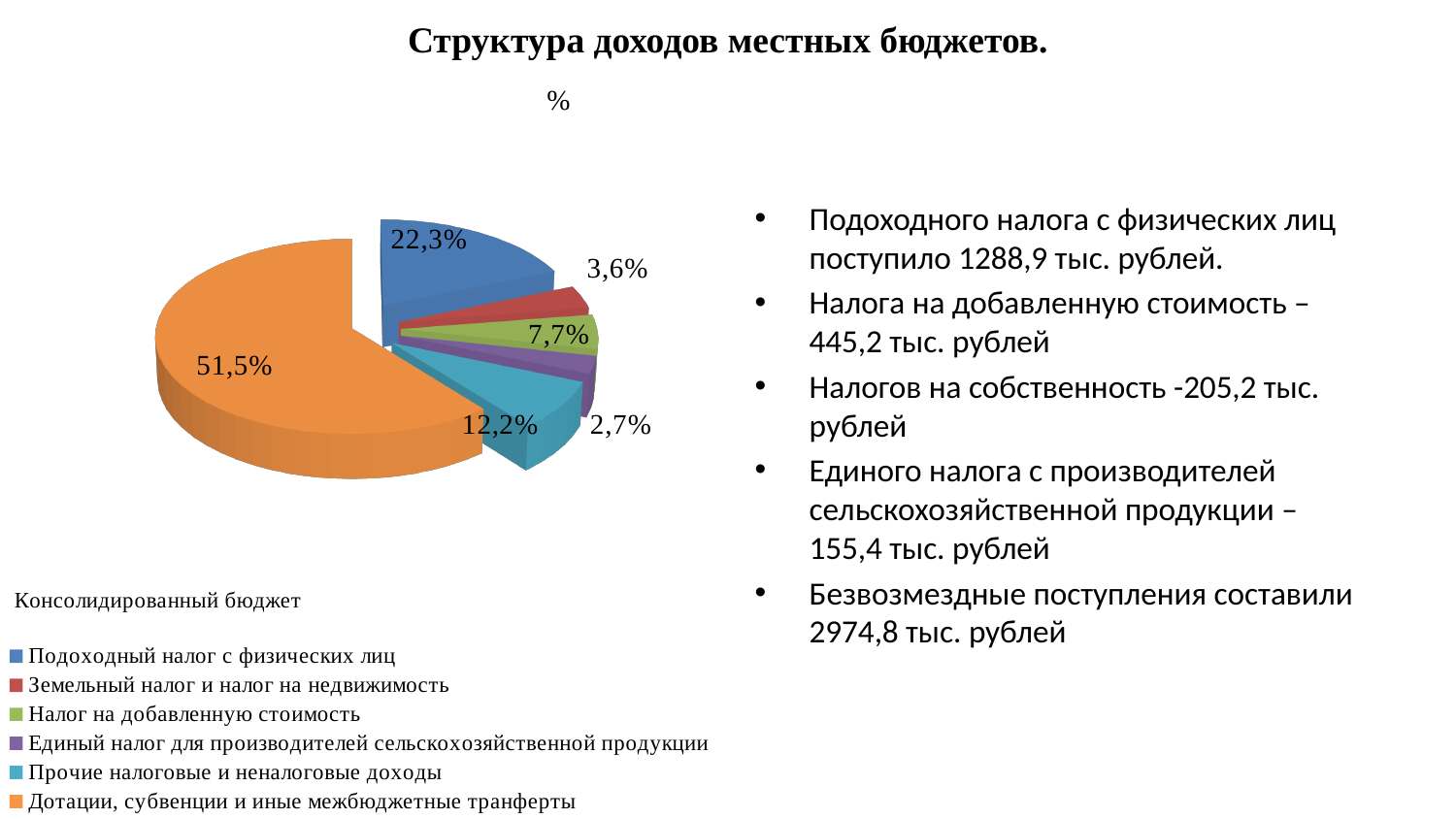
Which is larger: the share for Земельный налог и налог на недвижимость or the share for Налог на добавленную стоимость? Налог на добавленную стоимость What value is shown for Единый налог для производителей сельскохозяйственной продукции? 2,7% What value is shown for Налог на добавленную стоимость? 7,7% What kind of chart is shown on the slide? Pie chart Which category has the largest slice of the pie? Дотации, субвенции и иные межбюджетные трансферты Which category has the smallest slice of the pie? Единый налог для производителей сельскохозяйственной продукции What value is shown for Прочие налоговые и неналоговые доходы? 12,2% What share of the pie is labelled for Дотации, субвенции и иные межбюджетные трансферты? 51,5% What is the difference between the shares of Дотации, субвенции и иные межбюджетные трансферты and Подоходный налог с физических лиц? 29,2% What colour is the slice for Прочие налоговые и неналоговые доходы? Teal (light blue) How many slices does the pie chart have? 6 What share of the pie is labelled for Подоходный налог с физических лиц? 22,3%